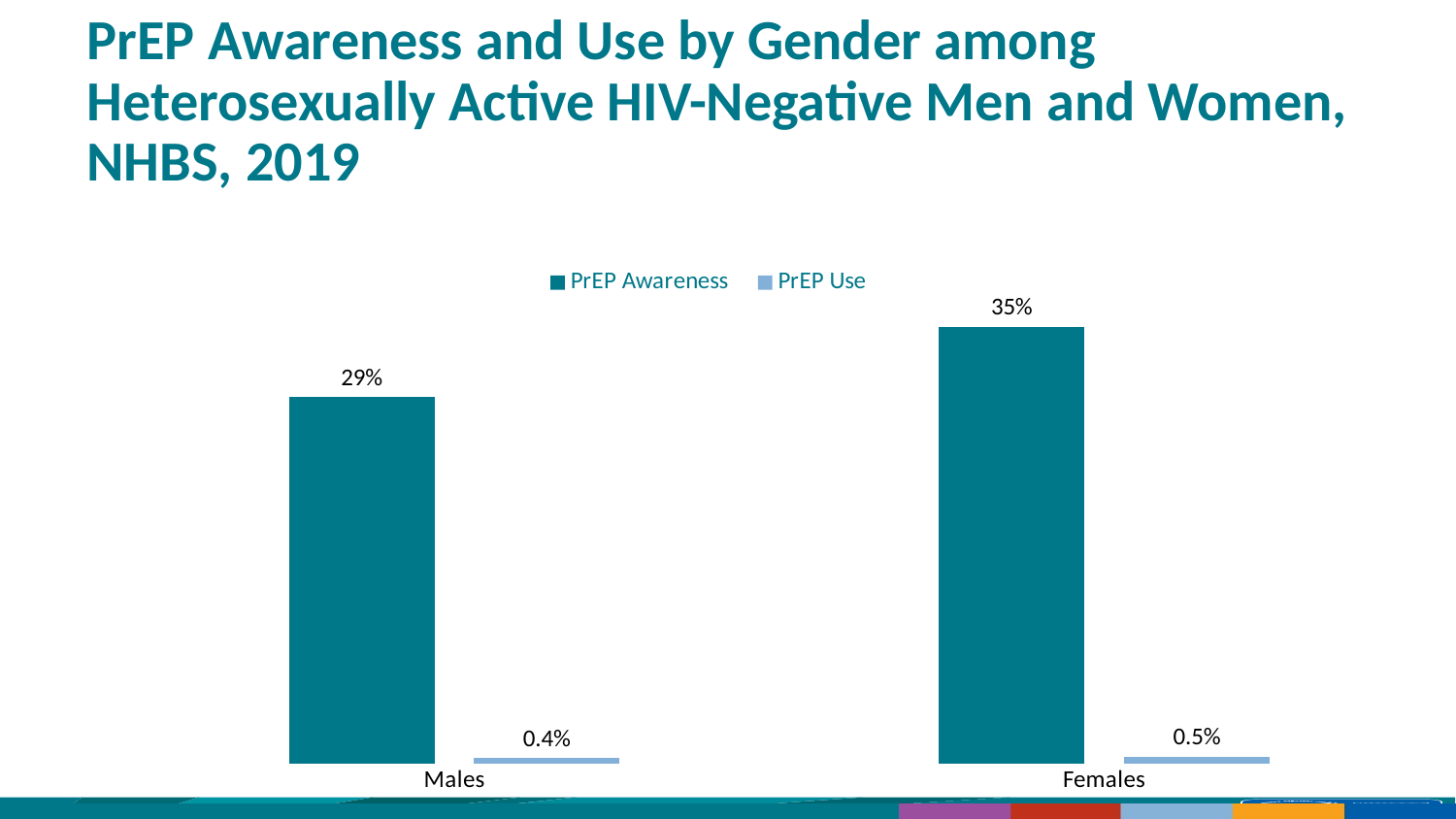
Is PrEP Awareness higher for Males or Females? Females Which gender has the higher PrEP Awareness value? Females What is the PrEP Use value for Females? 0.5% What kind of chart is shown on the slide? Bar chart What are the two series named in the legend? PrEP Awareness and PrEP Use What is the difference in PrEP Awareness between Females and Males? 6% What is the PrEP Use value for Males? 0.4% How many series does the legend list? 2 How many gender categories are shown on the x axis? 2 Which gender has the lower PrEP Use value? Males What is the PrEP Awareness value for Females? 35% What is the PrEP Awareness value for Males? 29%